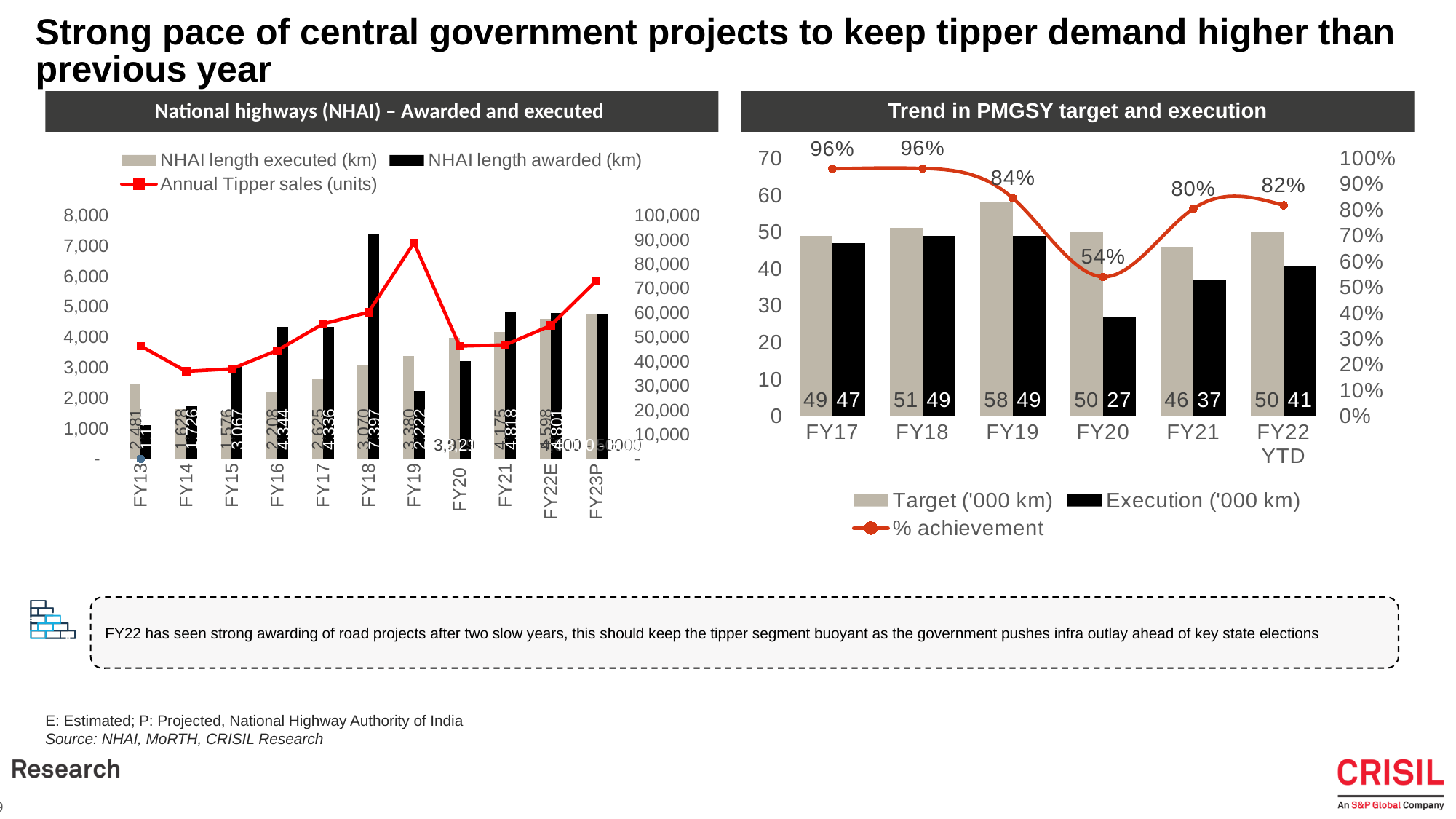
In the 'Trend in PMGSY target and execution' chart, what is the difference between Target and Execution for FY20? 23 How many series does the legend of the 'Trend in PMGSY target and execution' chart list? 3 In the 'Trend in PMGSY target and execution' chart, what is the Target ('000 km) value for FY19? 58 How many fiscal-year categories are shown on the x axis of the 'National highways (NHAI) – Awarded and executed' chart? 11 In the 'Trend in PMGSY target and execution' chart, which year has the highest Target ('000 km)? FY19 In the 'Trend in PMGSY target and execution' chart, what is the % achievement for FY22 YTD? 82% In the 'National highways (NHAI) – Awarded and executed' chart, what is the NHAI length awarded (km) for FY18? 7,397 In the 'Trend in PMGSY target and execution' chart, which year has the lowest % achievement? FY20 In the 'National highways (NHAI) – Awarded and executed' chart, in which year does the Annual Tipper sales line reach its peak? FY19 In the 'National highways (NHAI) – Awarded and executed' chart, is the Annual Tipper sales value for FY19 greater or less than 80,000 units? greater In the 'Trend in PMGSY target and execution' chart, what is the Execution ('000 km) value for FY20? 27 In the 'Trend in PMGSY target and execution' chart, is the Execution value for FY21 larger or smaller than the Execution value for FY22 YTD? smaller